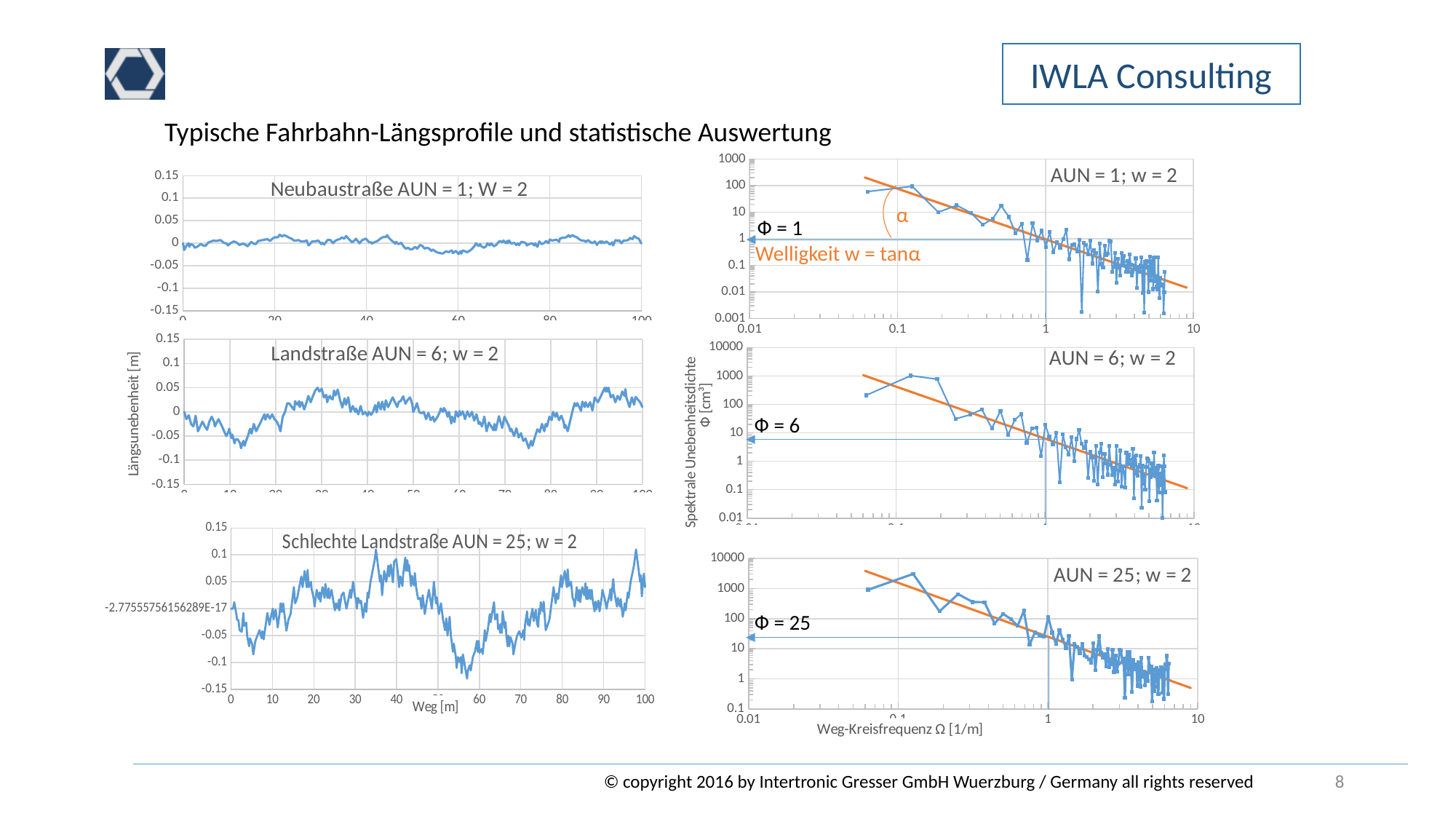
In the 'Landstraße AUN = 6; w = 2' chart, is the lowest value of the profile greater or less than -0.05? less In the 'AUN = 25; w = 2' chart on the right, do the plotted values rise or fall as the Weg-Kreisfrequenz Ω increases? fall Which of the three road profile charts on the left shows the largest fluctuations in Längsunebenheit? Schlechte Landstraße AUN = 25; w = 2 In the 'AUN = 6; w = 2' chart on the right, what value of Φ is marked by the horizontal reference line? Φ = 6 What text labels the orange fitted line in the top-right 'AUN = 1; w = 2' chart? Welligkeit w = tanα In the 'Neubaustraße AUN = 1; W = 2' chart, is the highest value of the profile greater or less than 0.05? less What kind of chart is the 'Neubaustraße AUN = 1; W = 2' chart on the left of the slide? line chart How many charts are shown on the slide in total? 6 What is the label of the x axis of the bottom-right chart? Weg-Kreisfrequenz Ω [1/m] In the 'AUN = 25; w = 2' chart on the right, what value of Φ is marked by the horizontal reference line? Φ = 25 In the 'Schlechte Landstraße AUN = 25; w = 2' chart, is the highest value of the profile greater or less than 0.1? greater In the 'AUN = 1; w = 2' chart on the right, what value of Φ is marked by the horizontal reference line? Φ = 1